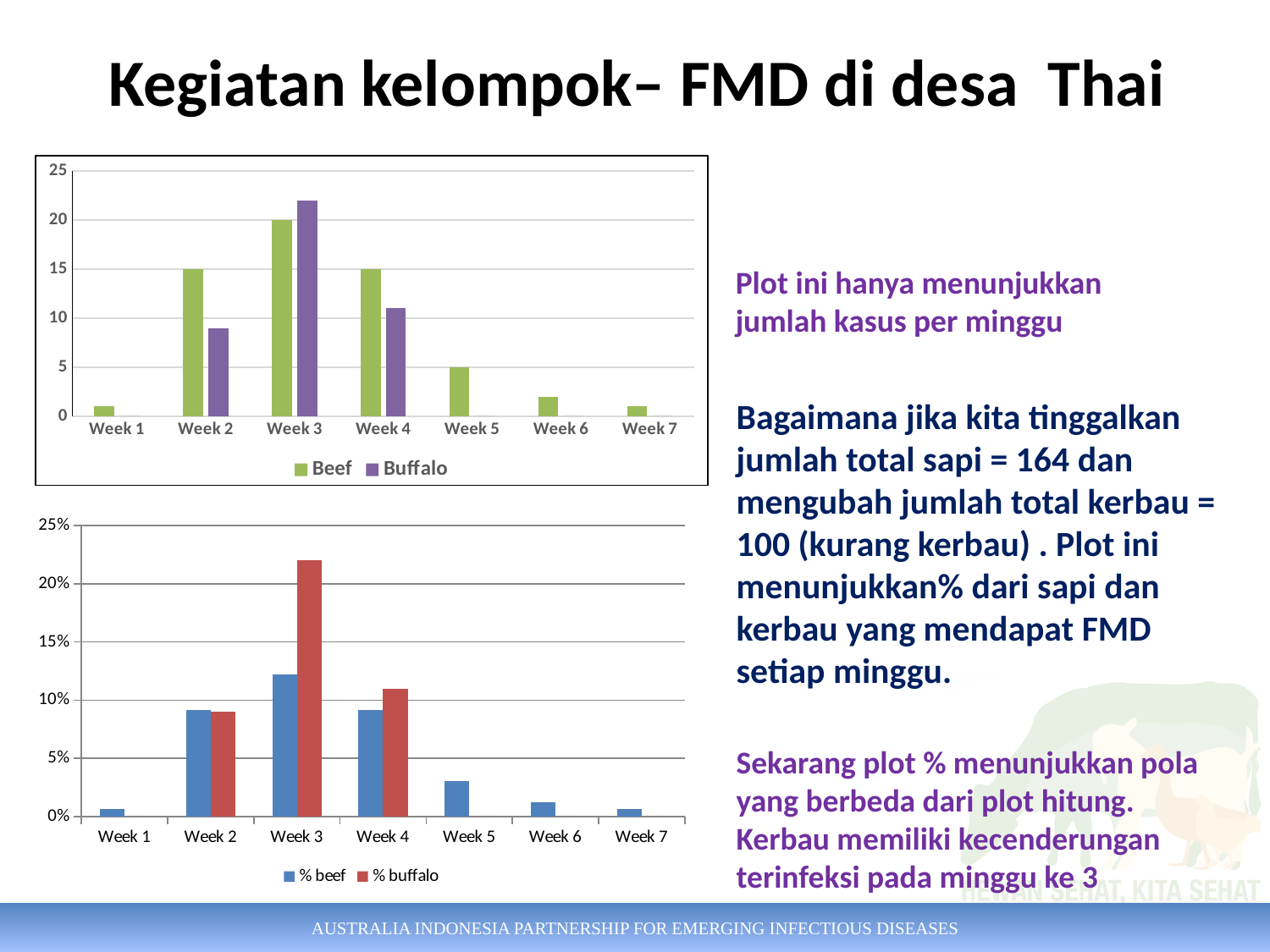
In the bottom chart, is the % buffalo value for Week 3 greater or less than 20%? greater In the bottom chart, which week has the highest % buffalo value? Week 3 How many series does the legend of the top chart list? 2 What kind of chart is the top chart on the slide? bar chart In the top chart, what is the Beef value for Week 2? 15 In the top chart, is the Buffalo value for Week 3 greater or less than 20? greater What are the two legend entries of the bottom chart? % beef and % buffalo How many weeks are shown on the x axis of the top chart? 7 In the top chart, which week has the highest Beef value? Week 3 In the bottom chart, is the % beef value for Week 3 greater or less than 10%? greater In the bottom chart, which series has the larger value in Week 3, % beef or % buffalo? % buffalo In the top chart, what is the Beef value for Week 3? 20